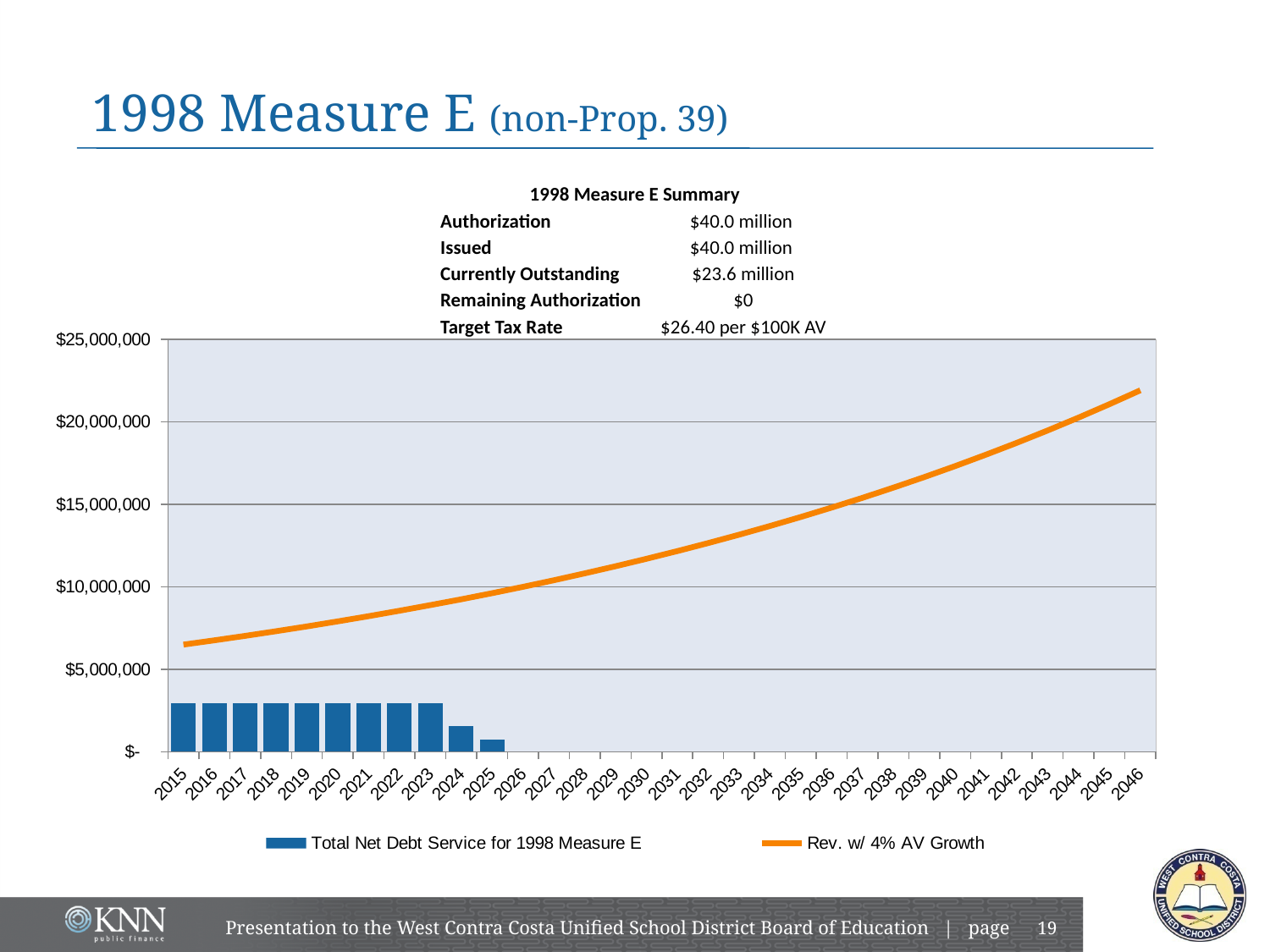
Is the Rev. w/ 4% AV Growth value for 2015 greater or less than $10,000,000? less How many years on the x axis have a Total Net Debt Service for 1998 Measure E bar? 11 Is the Total Net Debt Service for 1998 Measure E bar for 2015 greater or less than $5,000,000? less What kind of chart is shown on the slide? A combination bar and line chart Which is larger, the Rev. w/ 4% AV Growth value for 2030 or for 2040? 2040 What colour is the Rev. w/ 4% AV Growth line in the chart? Orange Is the Rev. w/ 4% AV Growth value for 2046 greater or less than $20,000,000? greater How many years are shown on the x axis of the chart? 32 How many series does the chart legend list? 2 Which year has the smallest Total Net Debt Service for 1998 Measure E bar among the years that have a bar? 2025 Does the Rev. w/ 4% AV Growth line rise or fall from 2015 to 2046? Rises